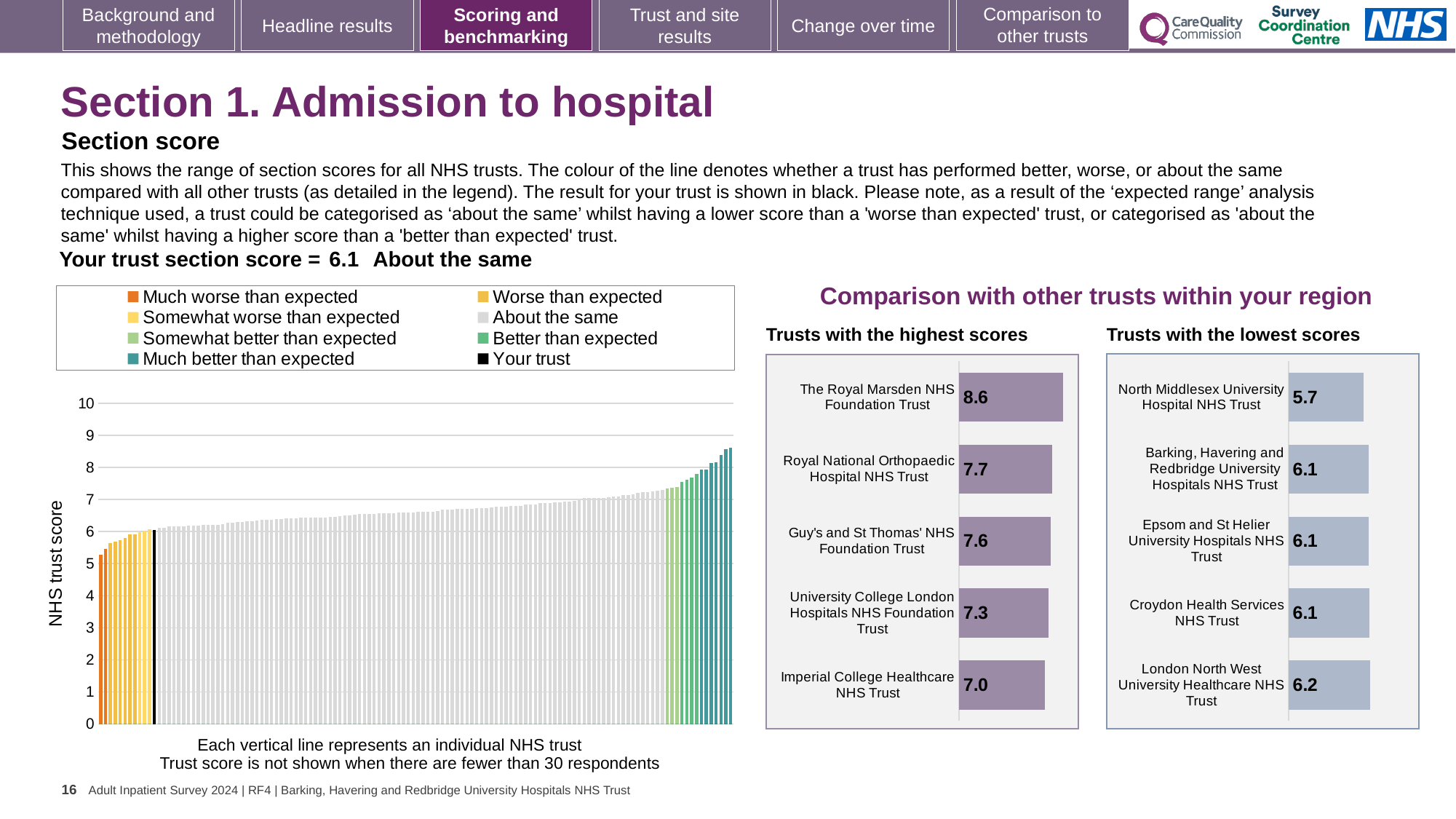
In the 'Trusts with the lowest scores' chart, what is the score for London North West University Healthcare NHS Trust? 6.2 In the 'Trusts with the highest scores' chart, what is the score for The Royal Marsden NHS Foundation Trust? 8.6 In the 'Trusts with the highest scores' chart, which has the higher score: Guy's and St Thomas' NHS Foundation Trust or University College London Hospitals NHS Foundation Trust? Guy's and St Thomas' NHS Foundation Trust In the 'Trusts with the lowest scores' chart, which trust has the lowest score? North Middlesex University Hospital NHS Trust In the 'Trusts with the lowest scores' chart, what is the score for North Middlesex University Hospital NHS Trust? 5.7 In the 'Trusts with the highest scores' chart, which trust has the highest score? The Royal Marsden NHS Foundation Trust In the 'Trusts with the highest scores' chart, what is the difference between the scores of The Royal Marsden NHS Foundation Trust and Imperial College Healthcare NHS Trust? 1.6 In the large chart on the left showing all NHS trusts, do the scores rise or fall from left to right? rise What kind of chart is the 'Trusts with the lowest scores' chart? bar chart How many trusts are shown in the 'Trusts with the highest scores' chart? 5 In the large chart on the left showing all NHS trusts, is the value of the tallest bar greater or less than 8? greater How many entries does the legend of the large chart on the left list? 8